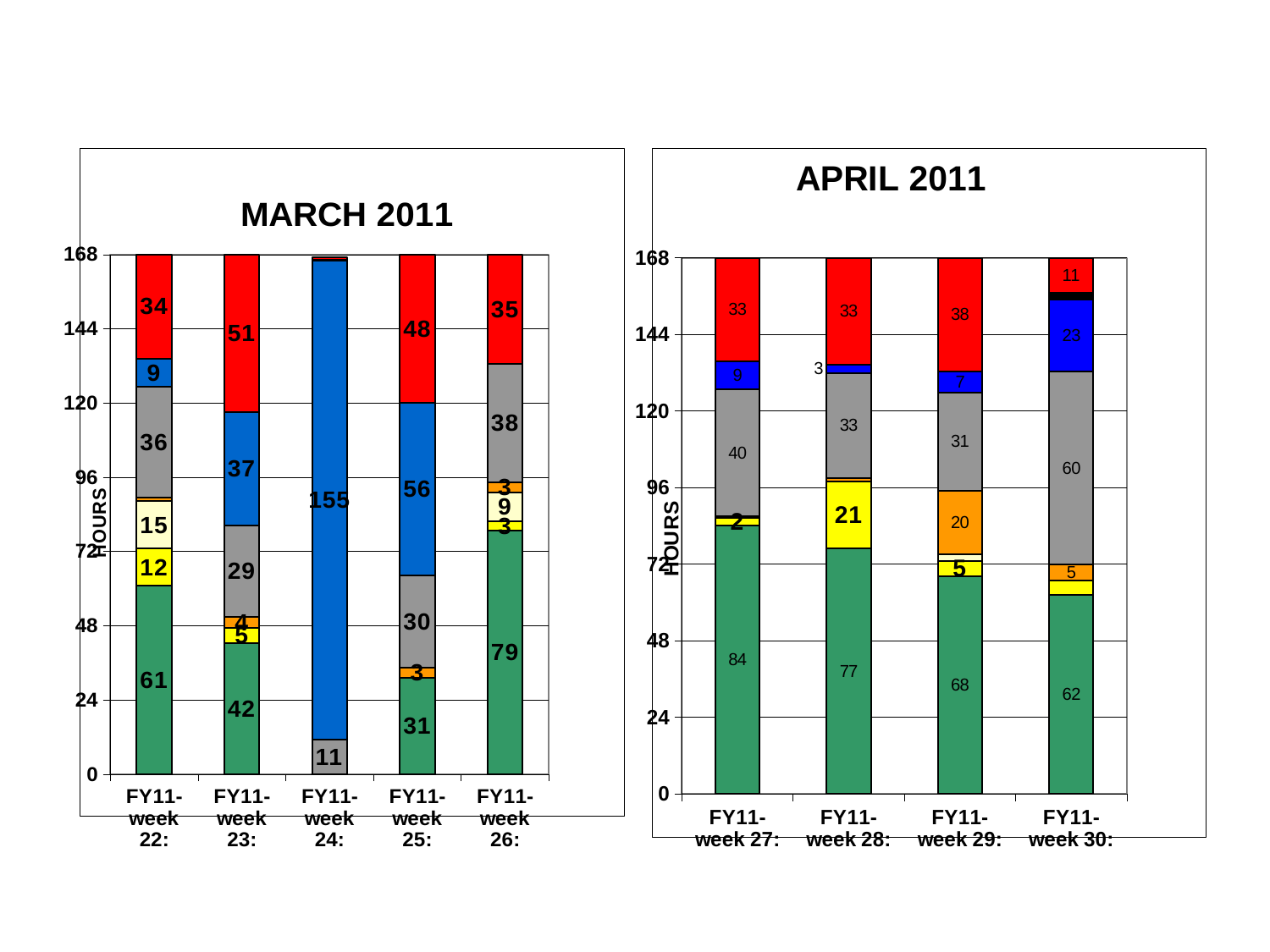
In the APRIL 2011 chart, which is larger: the gray segment for FY11-week 30 or the gray segment for FY11-week 27? FY11-week 30 In the APRIL 2011 chart, what is the value of the orange segment for FY11-week 29? 20 How many weeks are shown on the APRIL 2011 chart? 4 In the MARCH 2011 chart, which week has the largest green (bottom) segment? FY11-week 26 What kind of chart is the MARCH 2011 chart? stacked bar chart In the APRIL 2011 chart, which week has the smallest green (bottom) segment? FY11-week 30 In the MARCH 2011 chart, what is the total of the labelled segments for FY11-week 23? 168 What is the title of the chart on the right side of the slide? APRIL 2011 How many weeks are shown on the MARCH 2011 chart? 5 In the MARCH 2011 chart, what is the value of the large blue segment for FY11-week 24? 155 In the APRIL 2011 chart, what is the value of the green segment for FY11-week 30? 62 In the MARCH 2011 chart, what is the difference between the red segment for FY11-week 23 and the red segment for FY11-week 22? 17